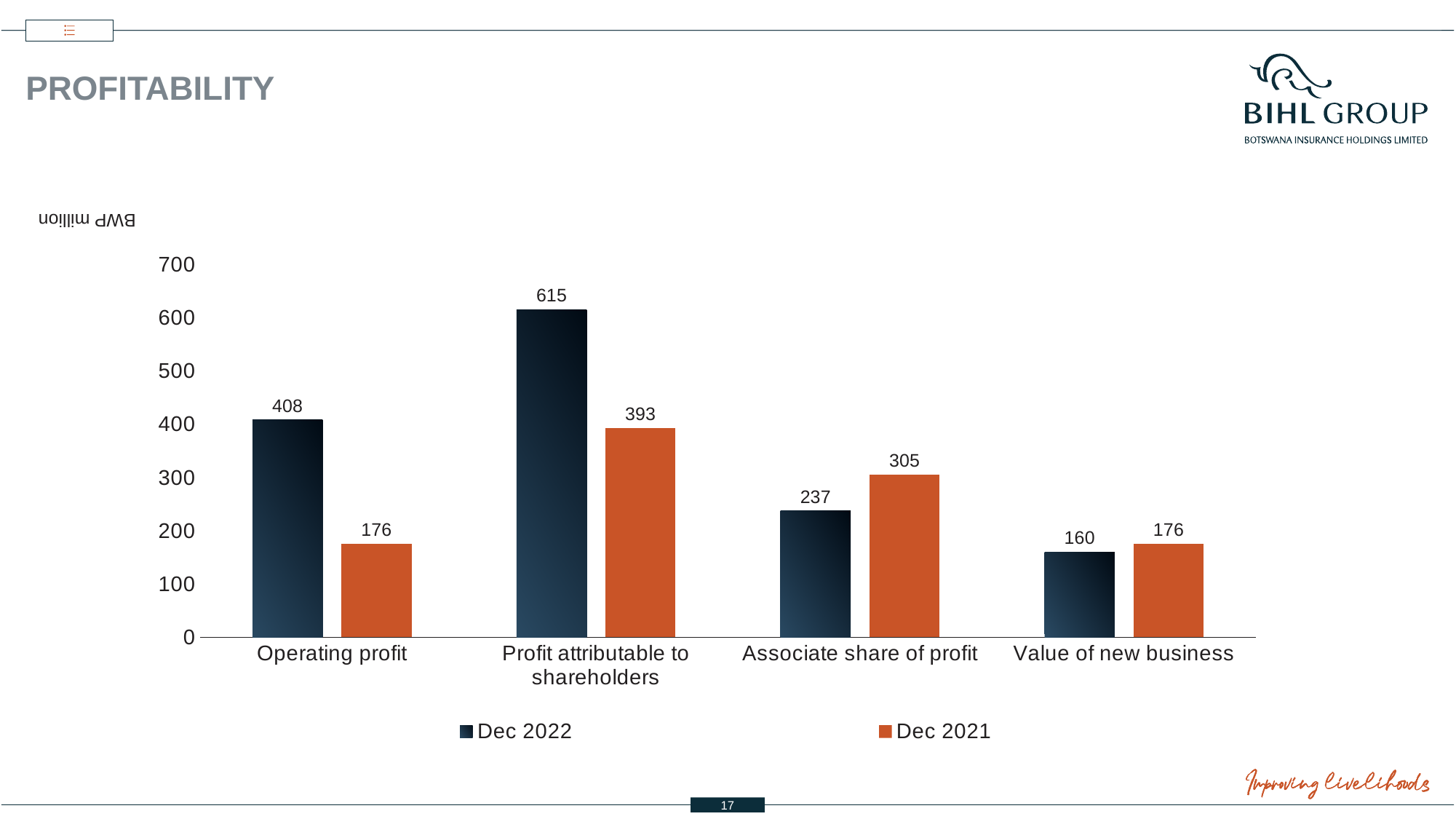
What kind of chart is shown on the slide? Bar chart What is the Dec 2021 value for Value of new business? 176 What is the Dec 2021 value for Profit attributable to shareholders? 393 How many series does the legend list? 2 What is the Dec 2022 value for Operating profit? 408 What unit is given for the y axis? BWP million Which category has the highest Dec 2022 value? Profit attributable to shareholders How many categories are shown on the x axis? 4 For Associate share of profit, which is larger: Dec 2022 or Dec 2021? Dec 2021 What is the difference between the Dec 2022 and Dec 2021 values for Operating profit? 232 What is the Dec 2022 value for Associate share of profit? 237 Which category has the lowest Dec 2021 value? Operating profit and Value of new business (both 176)